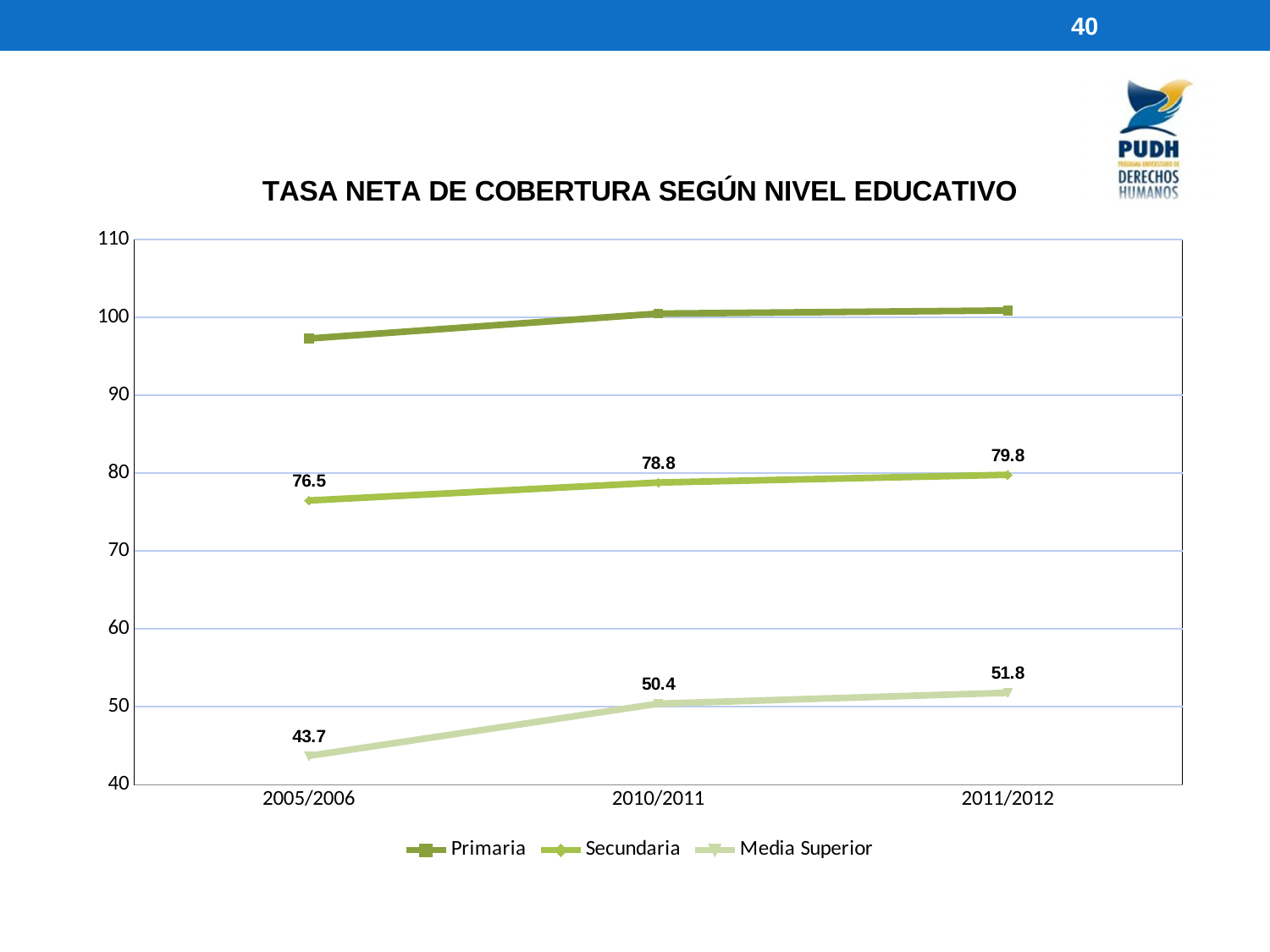
How many series does the legend list? 3 What is the value for Media Superior in 2005/2006? 43.7 Which is larger: Secundaria in 2011/2012 or Media Superior in 2011/2012? Secundaria in 2011/2012 What is the value for Secundaria in 2010/2011? 78.8 What is the value for Media Superior in 2011/2012? 51.8 What is the difference between the Media Superior values in 2011/2012 and 2005/2006? 8.1 What kind of chart is shown on the slide? Line chart Which year has the highest value for Secundaria? 2011/2012 Is the value for Primaria in 2005/2006 greater or less than 90? greater What is the value for Secundaria in 2005/2006? 76.5 Which year has the lowest value for Media Superior? 2005/2006 Do the Media Superior values rise or fall from 2005/2006 to 2011/2012? Rise